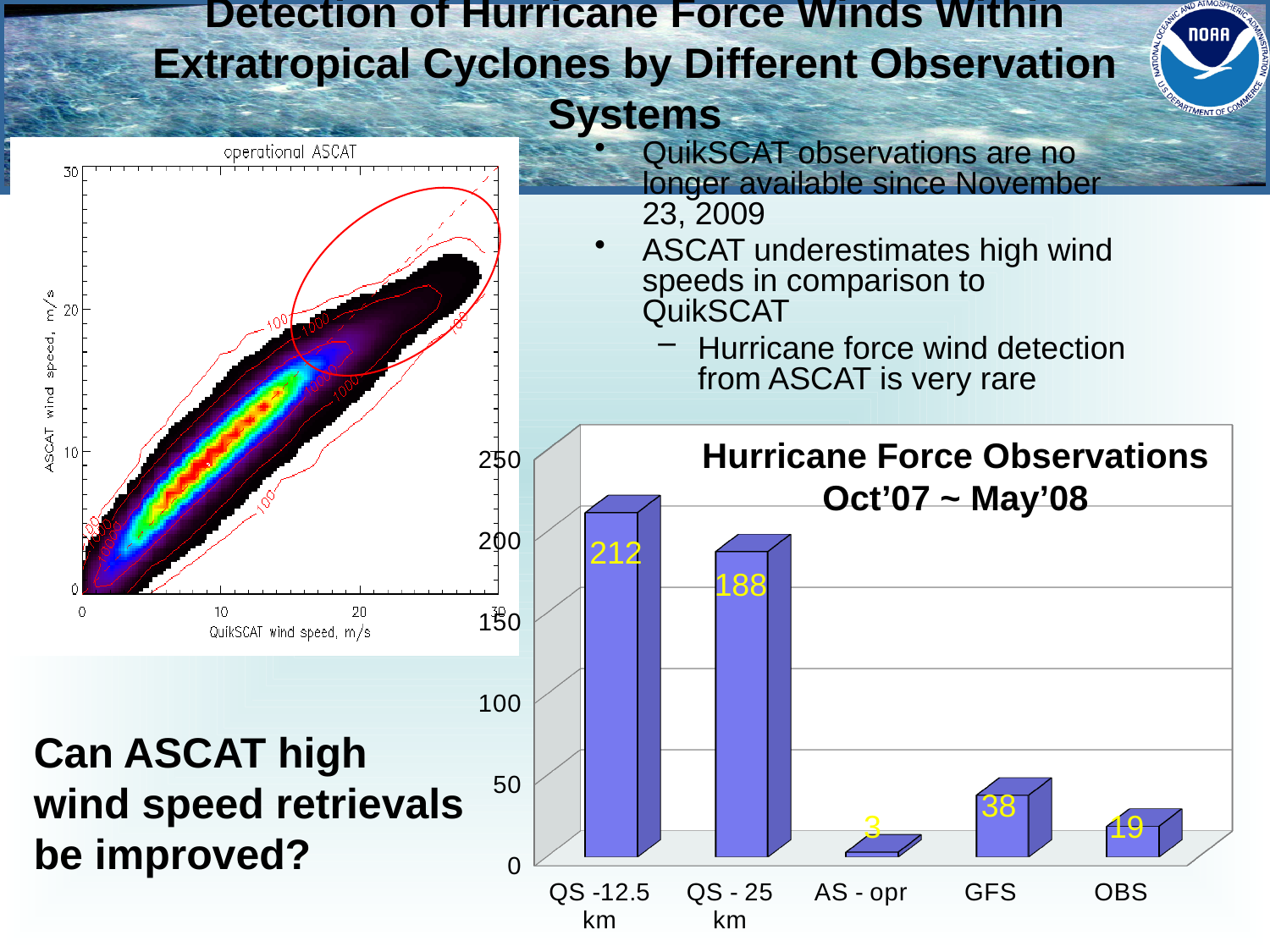
In the Hurricane Force Observations chart, what is the value for GFS? 38 In the Hurricane Force Observations chart, which is larger, the value for GFS or the value for OBS? GFS In the Hurricane Force Observations chart, what is the value for QS - 25 km? 188 In the Hurricane Force Observations chart, which category has the highest value? QS -12.5 km What kind of chart is the Hurricane Force Observations chart? bar chart In the Hurricane Force Observations chart, what is the difference between the values for QS -12.5 km and QS - 25 km? 24 In the Hurricane Force Observations chart, what is the value for QS -12.5 km? 212 In the Hurricane Force Observations chart, what is the value for AS - opr? 3 In the Hurricane Force Observations chart, which category has the lowest value? AS - opr What period is given in the title of the Hurricane Force Observations chart? Oct'07 ~ May'08 How many categories are shown in the Hurricane Force Observations chart? 5 In the Hurricane Force Observations chart, what is the value for OBS? 19